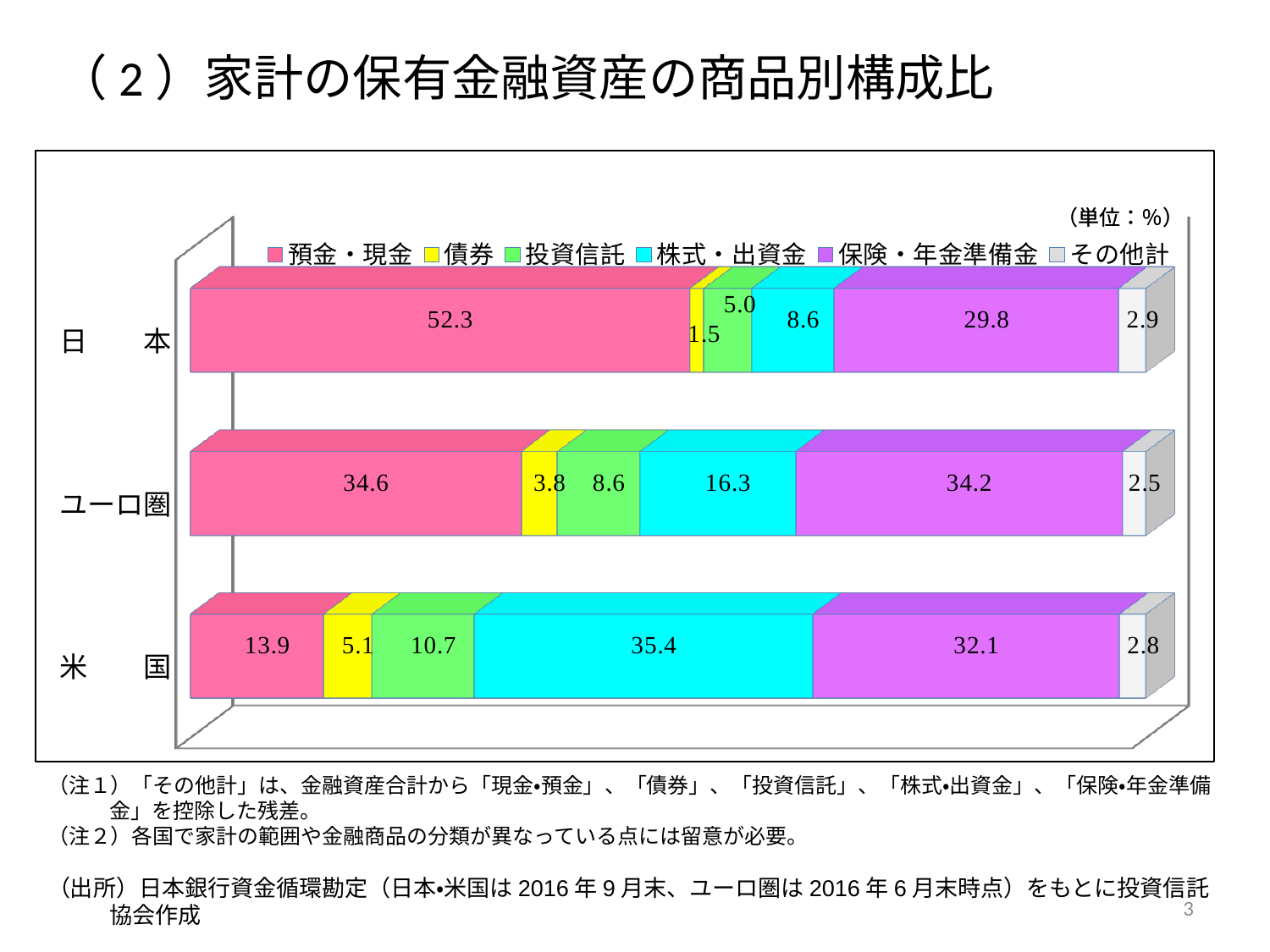
How many series does the legend list? 6 Which country/region has the highest value for 預金・現金? 日本 What unit is indicated for the values in the chart? % What is the value of 保険・年金準備金 for ユーロ圏? 34.2 What is the difference between the 株式・出資金 values for 米国 and ユーロ圏? 19.1 What is the value of 預金・現金 for 日本? 52.3 What is the value of 株式・出資金 for 米国? 35.4 What is the value of 債券 for 日本? 1.5 Which is larger: 投資信託 for 米国 or 投資信託 for ユーロ圏? 米国 Which country/region has the lowest value for 株式・出資金? 日本 What kind of chart is shown on the slide? Stacked bar chart How many countries/regions are plotted in the chart? 3